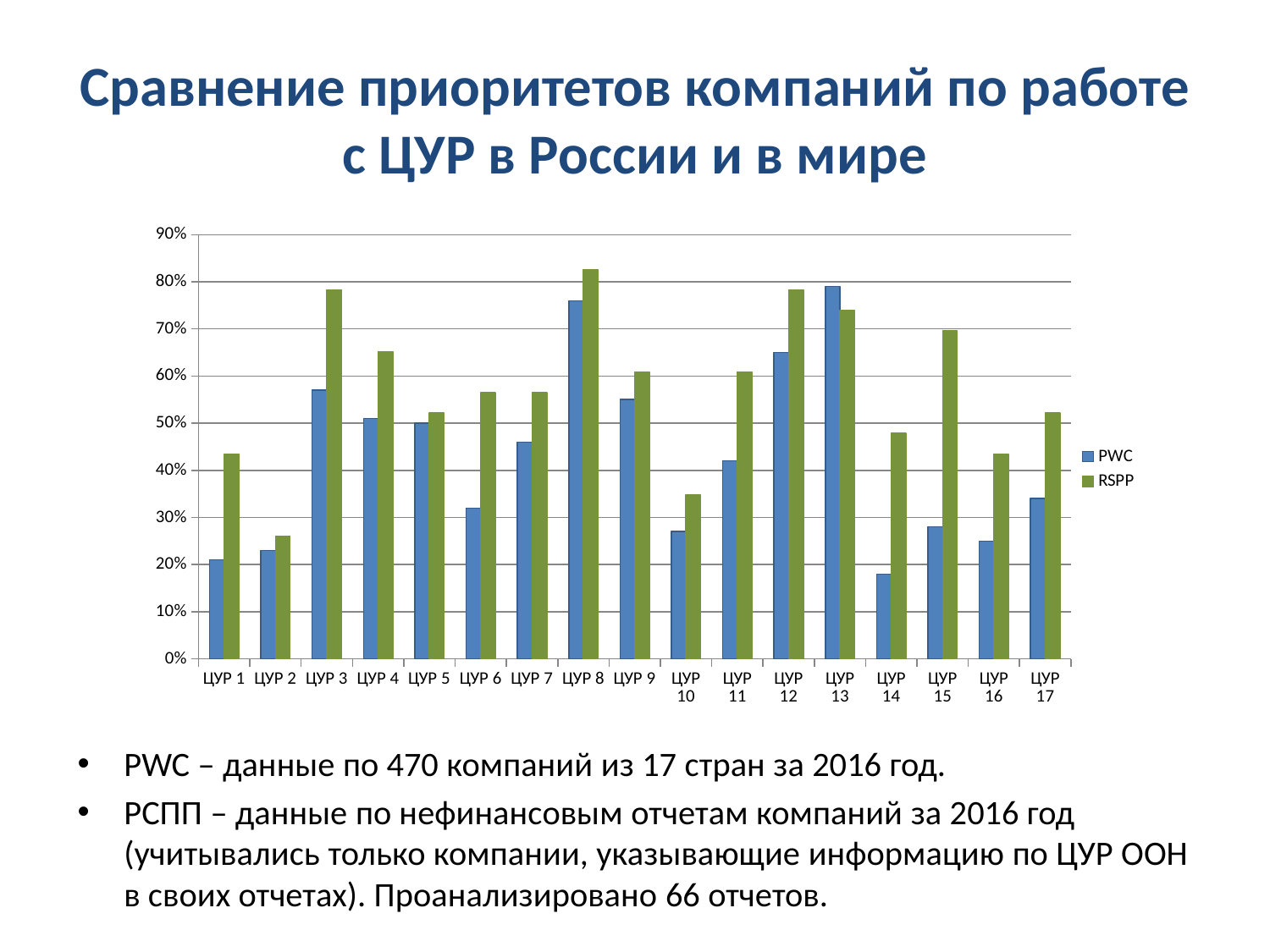
Which category has the lowest PWC value? ЦУР 14 Is the RSPP value for ЦУР 15 greater or less than 60%? greater Which category has the highest RSPP value? ЦУР 8 For ЦУР 13, which series has the larger value, PWC or RSPP? PWC How many ЦУР categories are shown on the x axis? 17 Is the PWC value for ЦУР 8 greater or less than 70%? greater What kind of chart is shown on the slide? Bar chart Which category has the lowest RSPP value? ЦУР 2 Is the RSPP value for ЦУР 2 greater or less than 30%? less How many series does the legend list? 2 Which series are listed in the legend? PWC and RSPP For ЦУР 1, which series has the larger value, PWC or RSPP? RSPP